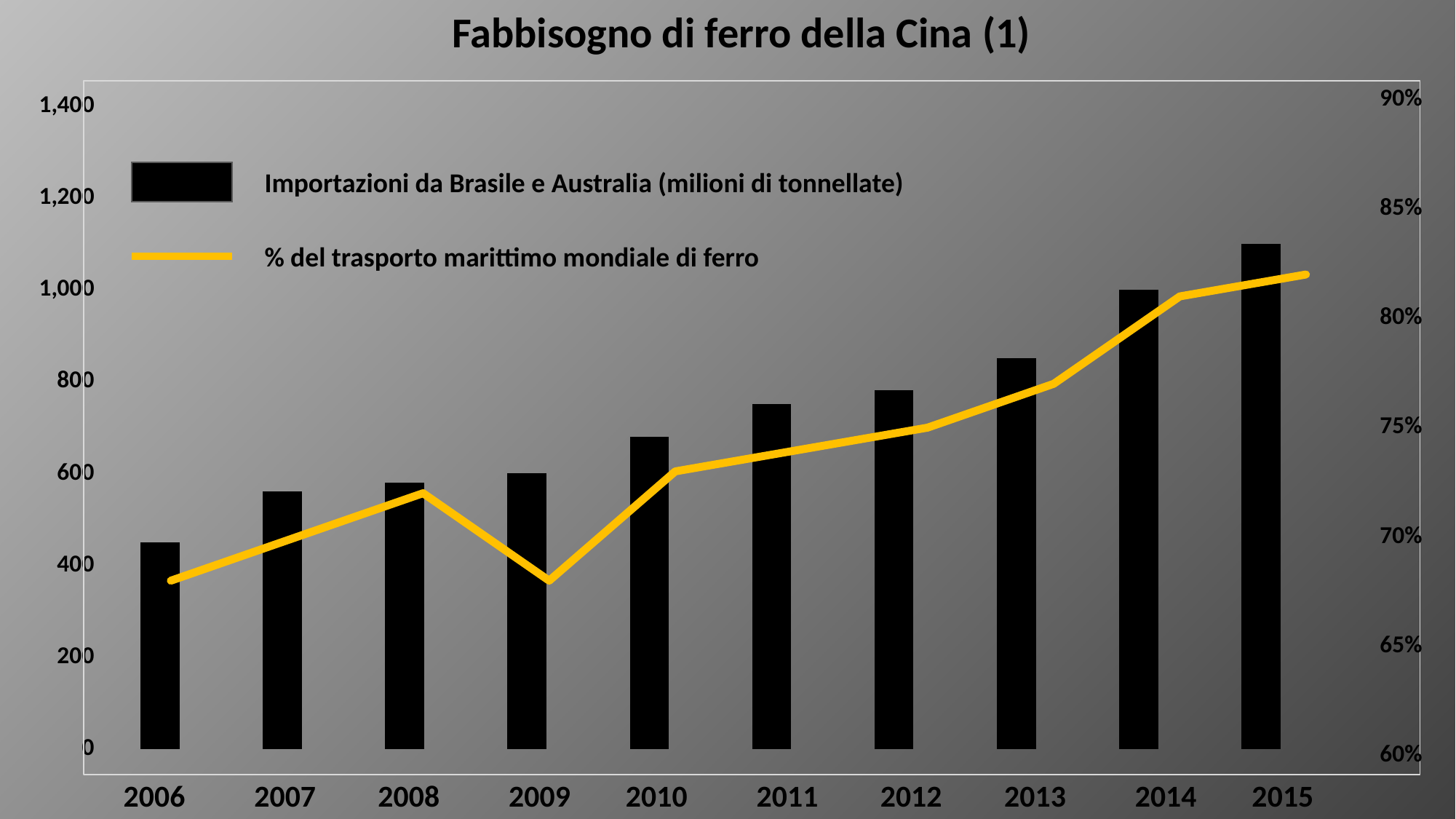
Do the bars for Importazioni da Brasile e Australia generally rise or fall from 2006 to 2015? rise How many years are shown on the x axis of the chart? 10 Is the value of % del trasporto marittimo mondiale di ferro in 2009 greater or less than 70%? less Which year has the lowest bar for Importazioni da Brasile e Australia? 2006 Which year has the highest bar for Importazioni da Brasile e Australia? 2015 What is the title of the chart? Fabbisogno di ferro della Cina (1) What kind of chart is shown on the slide? Combined bar and line chart Is the bar for Importazioni da Brasile e Australia in 2015 greater or less than 1,000? greater Which is larger, the bar for Importazioni da Brasile e Australia in 2013 or in 2014? 2014 How many series does the legend list? 2 Is the bar for Importazioni da Brasile e Australia in 2006 greater or less than 600? less